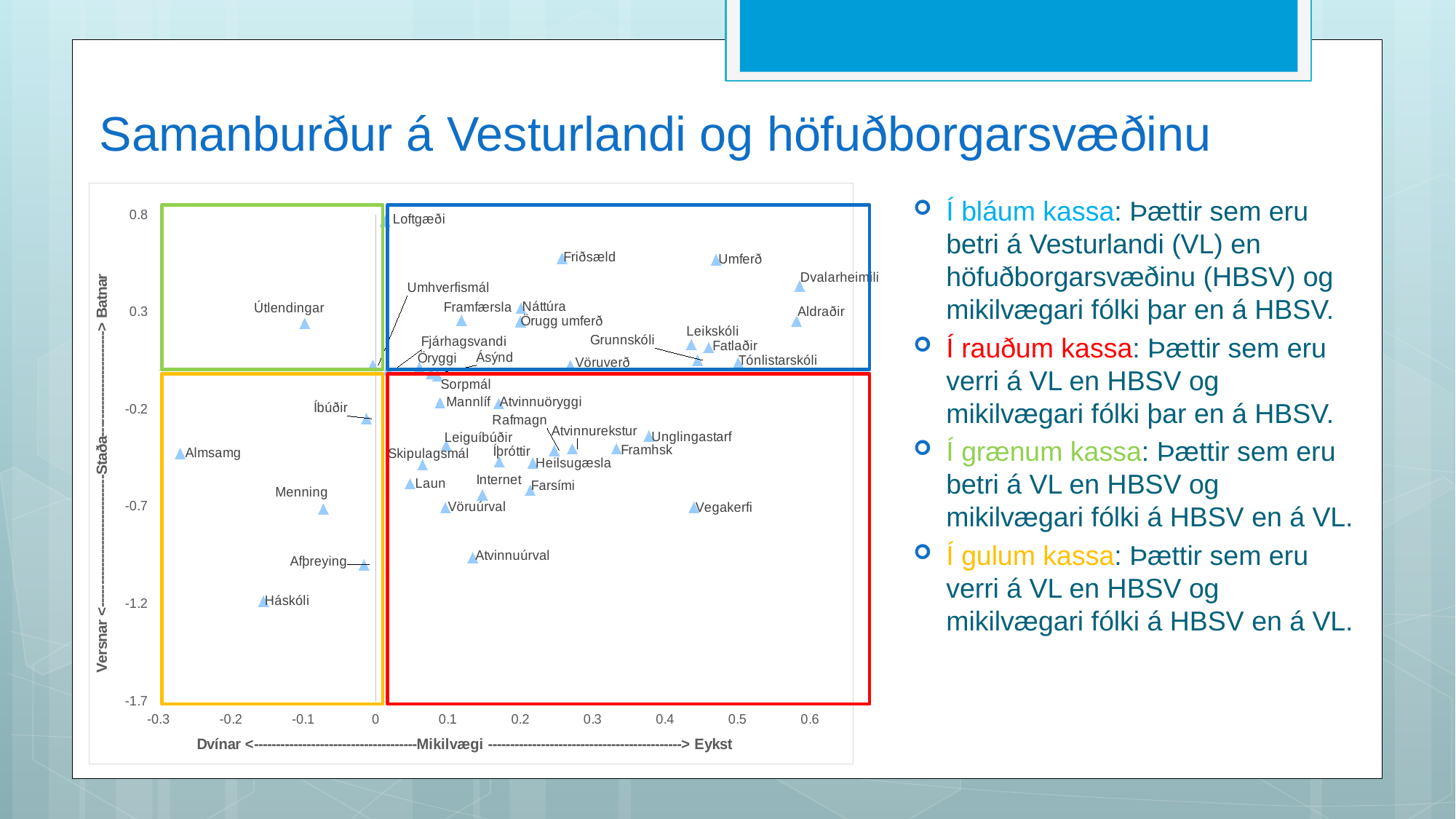
Is the vertical-axis value for Umferð greater or less than 0.3? greater How many coloured boxes are drawn on the chart? 4 Is the vertical-axis value for Háskóli greater or less than -0.7? less Which category has the highest value on the vertical (Staða) axis? Loftgæði Which is higher on the vertical axis, Friðsæld or Háskóli? Friðsæld Which category is furthest to the left on the horizontal (Mikilvægi) axis? Almsamg What kind of chart is shown on the slide? scatter chart Which category has the lowest value on the vertical (Staða) axis? Háskóli How many data points lie inside the yellow box? 5 Is the horizontal-axis value for Vegakerfi greater or less than 0.4? greater Which is further to the right on the horizontal axis, Umferð or Útlendingar? Umferð